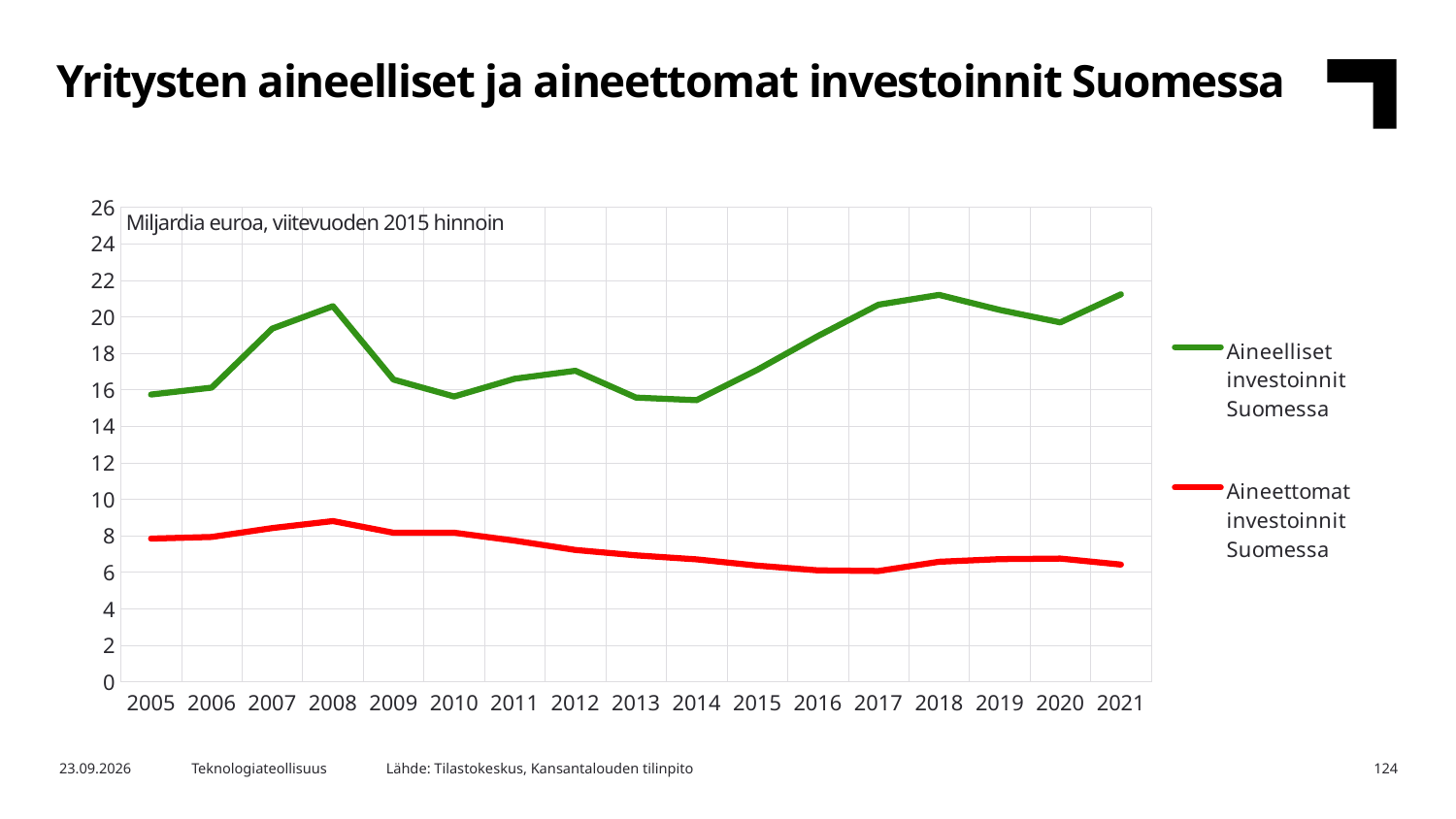
Is the value for Aineelliset investoinnit Suomessa in 2008 greater or less than 20? greater What kind of chart is shown on the slide? line chart Does the Aineettomat investoinnit Suomessa line rise or fall from 2008 to 2016? fall Which is larger for Aineettomat investoinnit Suomessa: the value in 2005 or the value in 2021? 2005 How many years are shown on the x axis? 17 Which is larger for Aineelliset investoinnit Suomessa: the value in 2007 or the value in 2009? 2007 Is the value for Aineelliset investoinnit Suomessa in 2014 greater or less than 16? less What unit is stated in the label inside the chart area? Miljardia euroa, viitevuoden 2015 hinnoin Is the value for Aineettomat investoinnit Suomessa in 2017 greater or less than 8? less In which year does Aineettomat investoinnit Suomessa reach its highest value? 2008 How many series does the legend list? 2